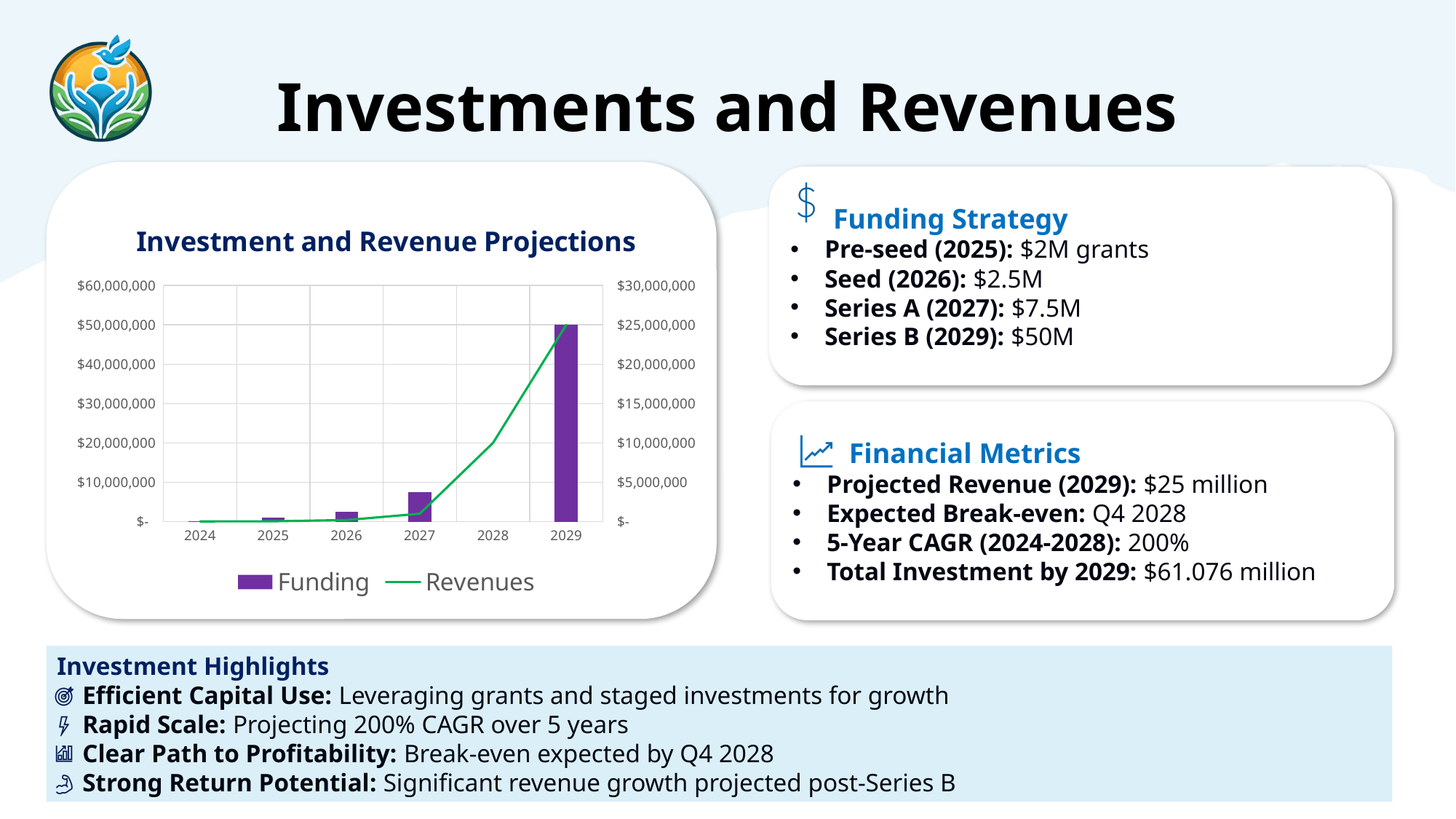
Do the Revenues values rise or fall from 2024 to 2029? rise Is the Funding value for 2027 greater or less than $10,000,000? less Which year has the highest Funding bar in the chart? 2029 Which is larger, the Funding bar for 2026 or the Funding bar for 2027? 2027 What is the Funding value for 2029 according to the left axis? $50,000,000 What kind of chart is shown on the slide? Combination bar and line chart Is the Revenues value for 2028 greater or less than $5,000,000 on the right axis? greater How many series does the chart's legend list? 2 Which series is drawn as a green line in the chart? Revenues Is the Funding value for 2029 greater or less than $40,000,000? greater How many years are shown on the x axis of the chart? 6 What is the title of the chart on the slide? Investment and Revenue Projections